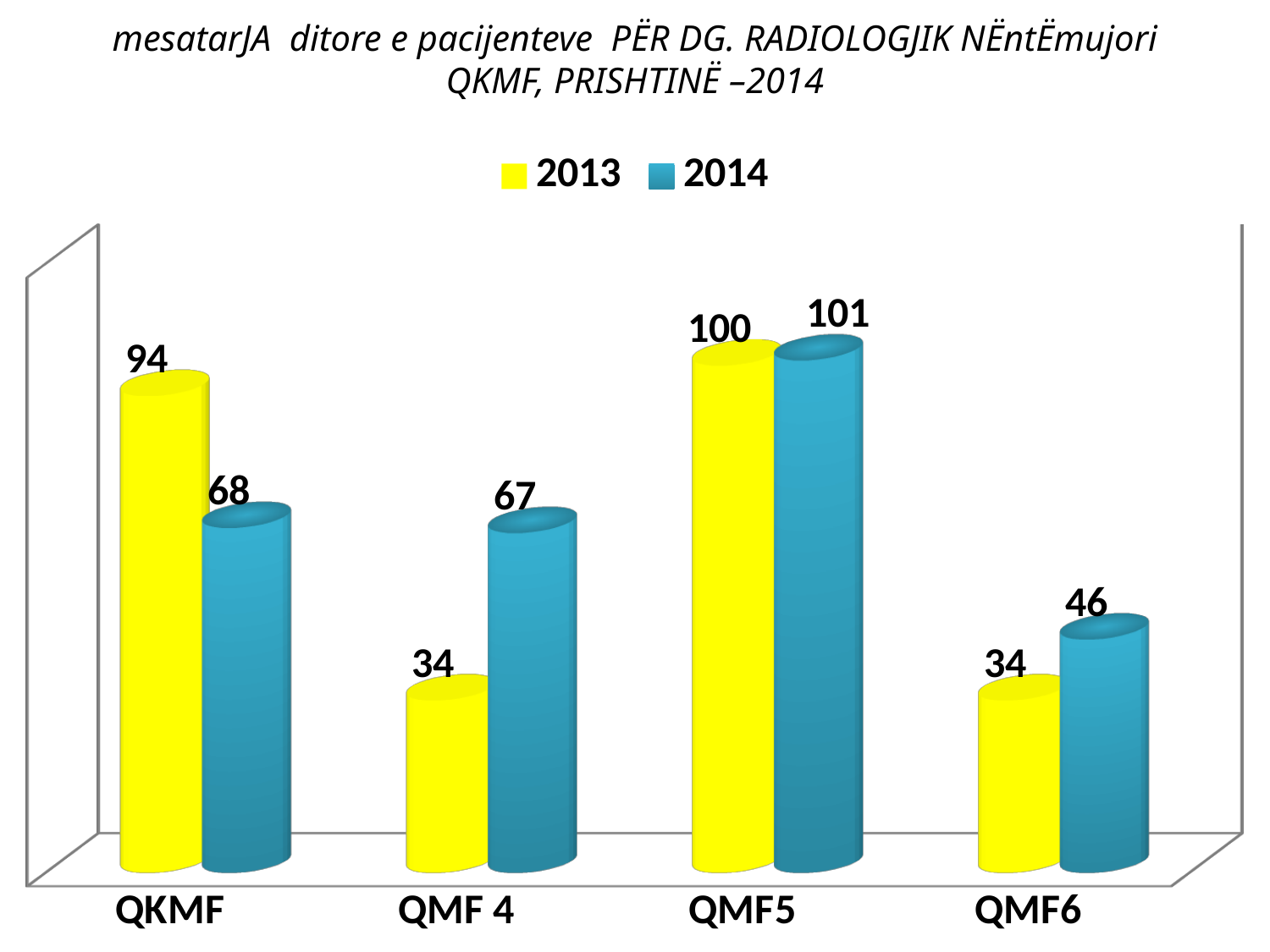
What is the difference between the 2013 and 2014 values for QKMF? 26 What is the value for QMF6 in 2014? 46 Which category has the highest value in the 2014 series? QMF5 What is the value for QKMF in 2013? 94 What is the difference between the 2014 values for QMF 4 and QMF6? 21 How many series does the legend list? 2 What kind of chart is shown on the slide? bar chart Which is larger for QMF 4: the 2013 value or the 2014 value? 2014 Which colour represents the 2013 series? yellow How many categories are shown on the x axis? 4 Which category has the lowest value in the 2014 series? QMF6 What is the value for QMF 4 in 2014? 67